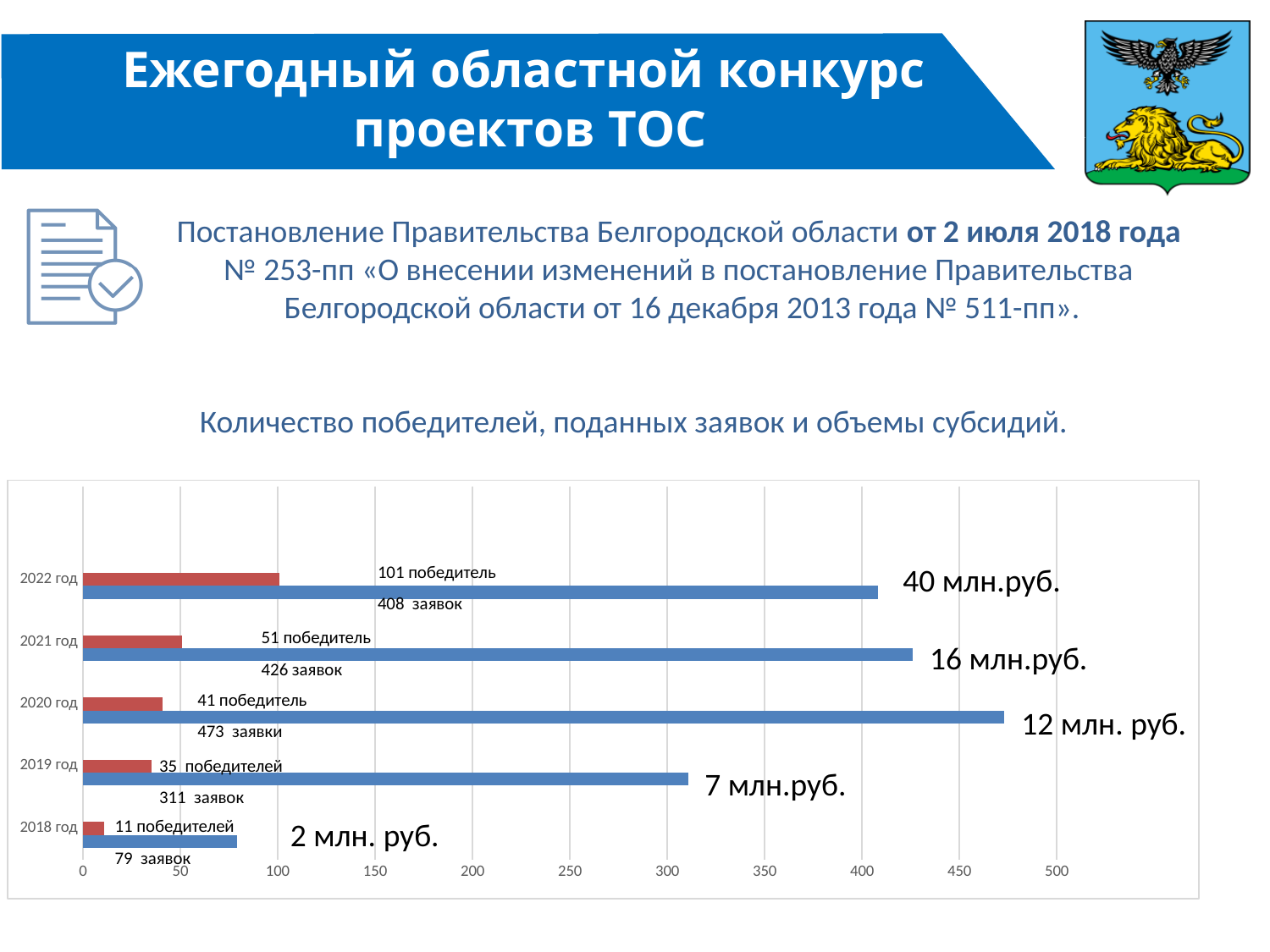
How many applications (заявок) were submitted in 2022? 408 Which is larger: the number of applications in 2021 or in 2022? 2021 What type of chart is shown on the slide? bar chart How many winners (победителей) were there in 2018? 11 Which year had the lowest number of winners? 2018 год Is the number of applications in 2019 greater or less than 300? greater What is the title of the chart on the slide? Количество победителей, поданных заявок и объемы субсидий. What is the difference between the number of winners in 2022 and in 2021? 50 How many years are shown on the chart? 5 Which year had the highest number of submitted applications? 2020 год Does the number of winners rise or fall from 2018 to 2022? rise What subsidy amount is shown for 2020? 12 млн. руб.